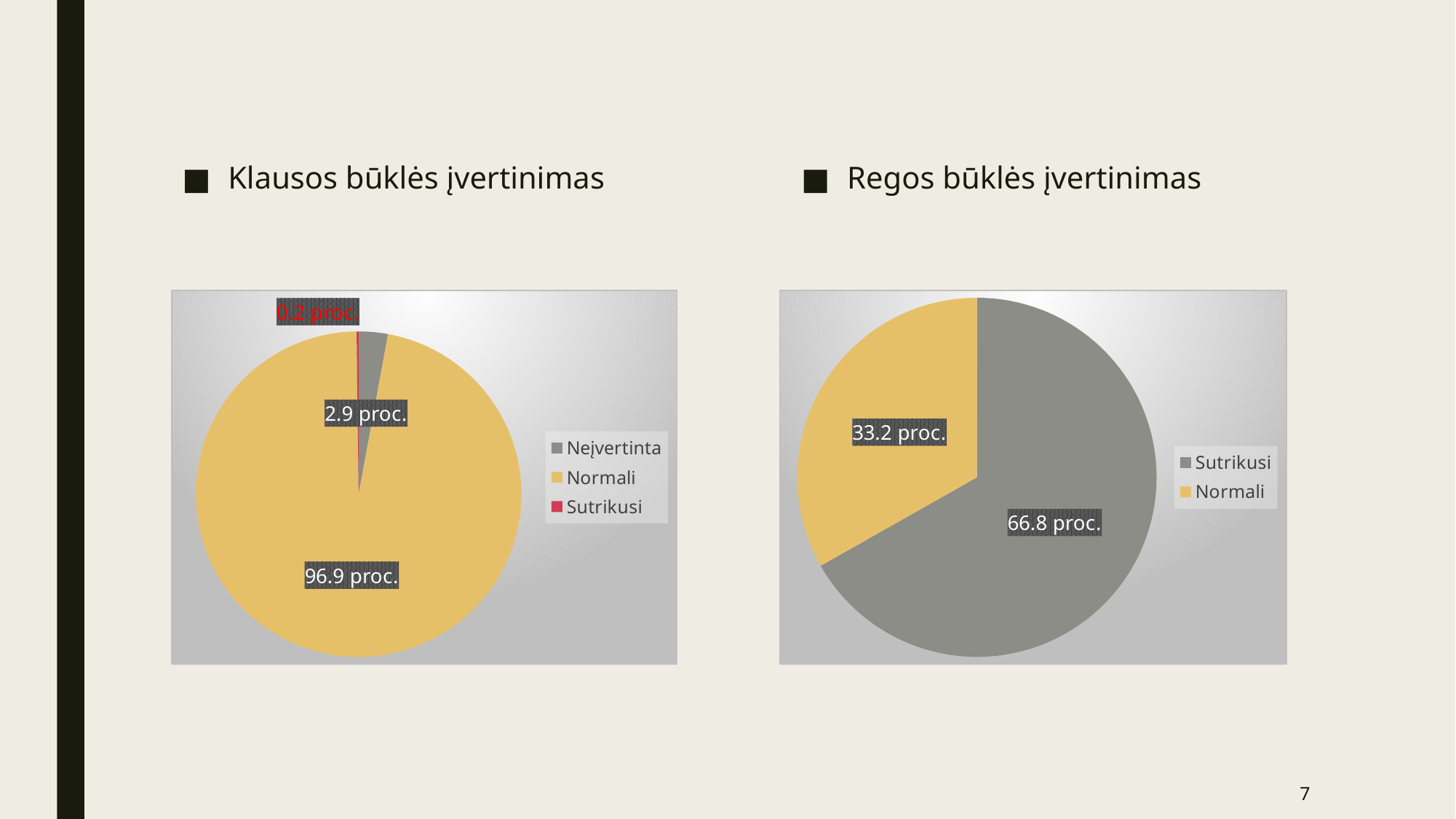
In the right chart (Regos būklės įvertinimas), what is the difference between the Sutrikusi and Normali shares? 33.6 proc. In the left chart (Klausos būklės įvertinimas), which category has the largest share? Normali In the right chart (Regos būklės įvertinimas), what is the value for Normali? 33.2 proc. In the right chart (Regos būklės įvertinimas), what is the value for Sutrikusi? 66.8 proc. In the right chart (Regos būklės įvertinimas), which category has the larger share? Sutrikusi In the left chart (Klausos būklės įvertinimas), what is the value for Normali? 96.9 proc. What type of chart is used on the left (Klausos būklės įvertinimas)? Pie chart In the left chart (Klausos būklės įvertinimas), how many categories does the legend list? 3 In the left chart (Klausos būklės įvertinimas), which category has the smallest share? Sutrikusi In the left chart (Klausos būklės įvertinimas), what is the value for Neįvertinta? 2.9 proc. In the right chart (Regos būklės įvertinimas), how many categories does the legend list? 2 In the left chart (Klausos būklės įvertinimas), what is the value for Sutrikusi? 0.2 proc.